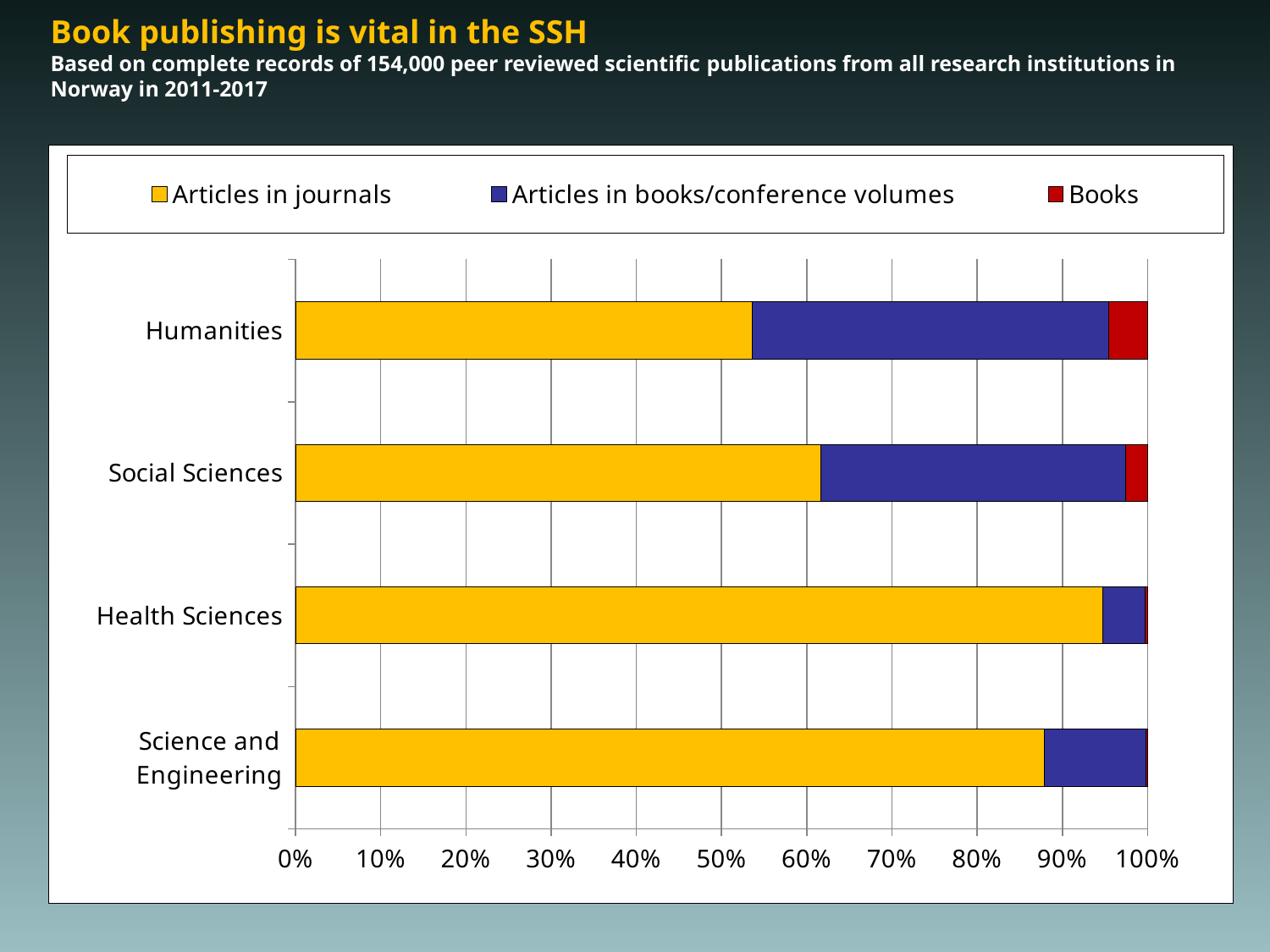
What is the title of the slide? Book publishing is vital in the SSH Which field has the largest share of Articles in books/conference volumes? Humanities What kind of chart is shown on the slide? Stacked bar chart Which field has the smallest share of Articles in journals? Humanities Which field has the largest share of Articles in journals? Health Sciences Which has a larger share of Articles in journals, Social Sciences or Humanities? Social Sciences Is the share of Articles in journals for Science and Engineering greater or less than 80%? greater How many series does the legend list? 3 How many categories (fields) are shown on the chart? 4 Is the share of Articles in journals for Social Sciences greater or less than 70%? less Which series is shown in red in the legend? Books Is the share of Articles in journals for Humanities greater or less than 50%? greater